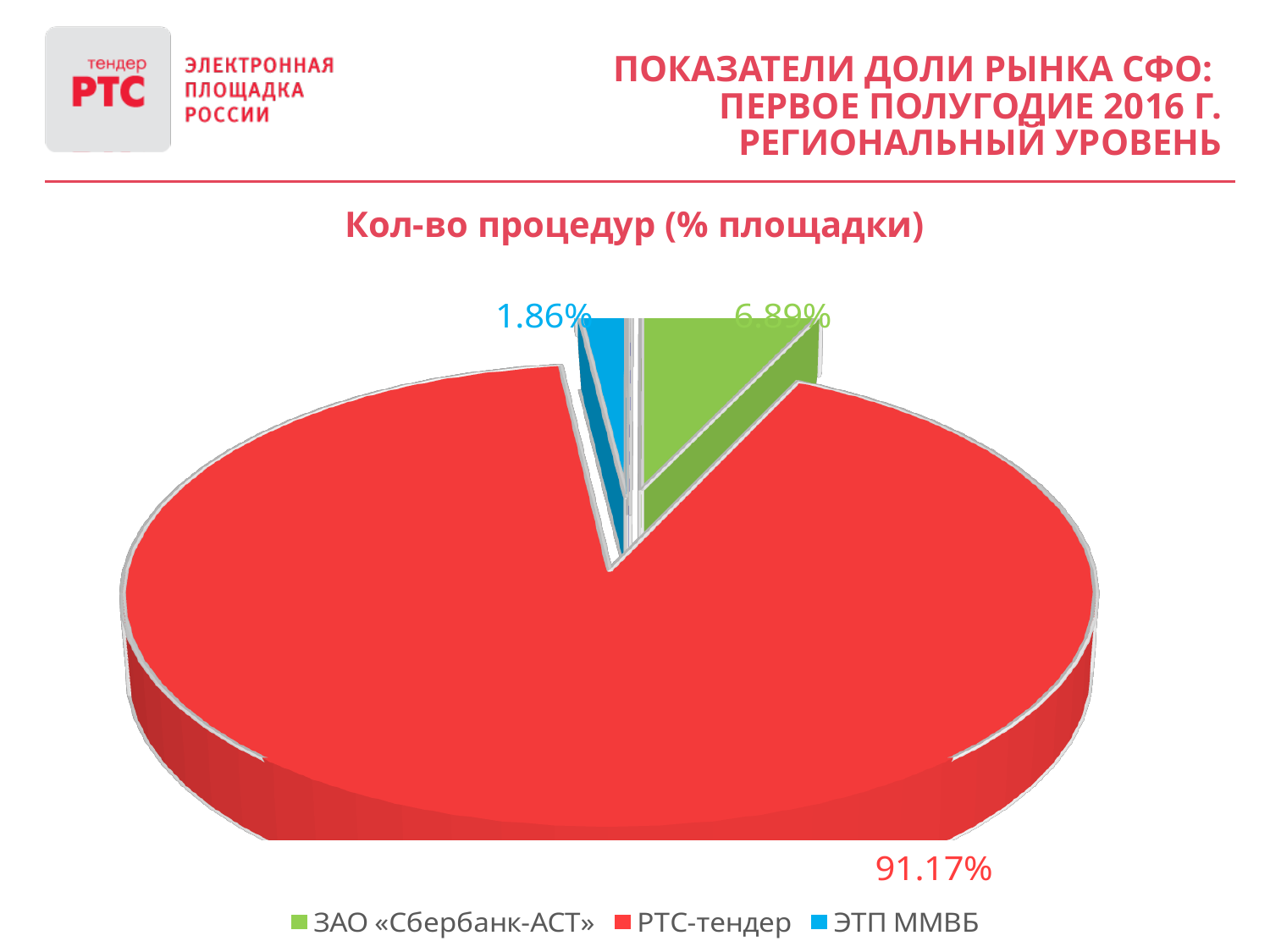
What type of chart is shown on the slide? pie chart Which colour represents ЭТП ММВБ in the chart? blue How many series does the legend list? 3 What is the title of the chart? Кол-во процедур (% площадки) What is the difference in percentage points between the shares of РТС-тендер and ЗАО «Сбербанк-АСТ»? 84.28 Which platform has the largest share of the pie? РТС-тендер How many slices does the pie chart have? 3 What share of the pie does ЗАО «Сбербанк-АСТ» have? 6.89% What share of the pie does ЭТП ММВБ have? 1.86% Which has a larger share: ЗАО «Сбербанк-АСТ» or ЭТП ММВБ? ЗАО «Сбербанк-АСТ» Which platform has the smallest share of the pie? ЭТП ММВБ What share of the pie does РТС-тендер have? 91.17%